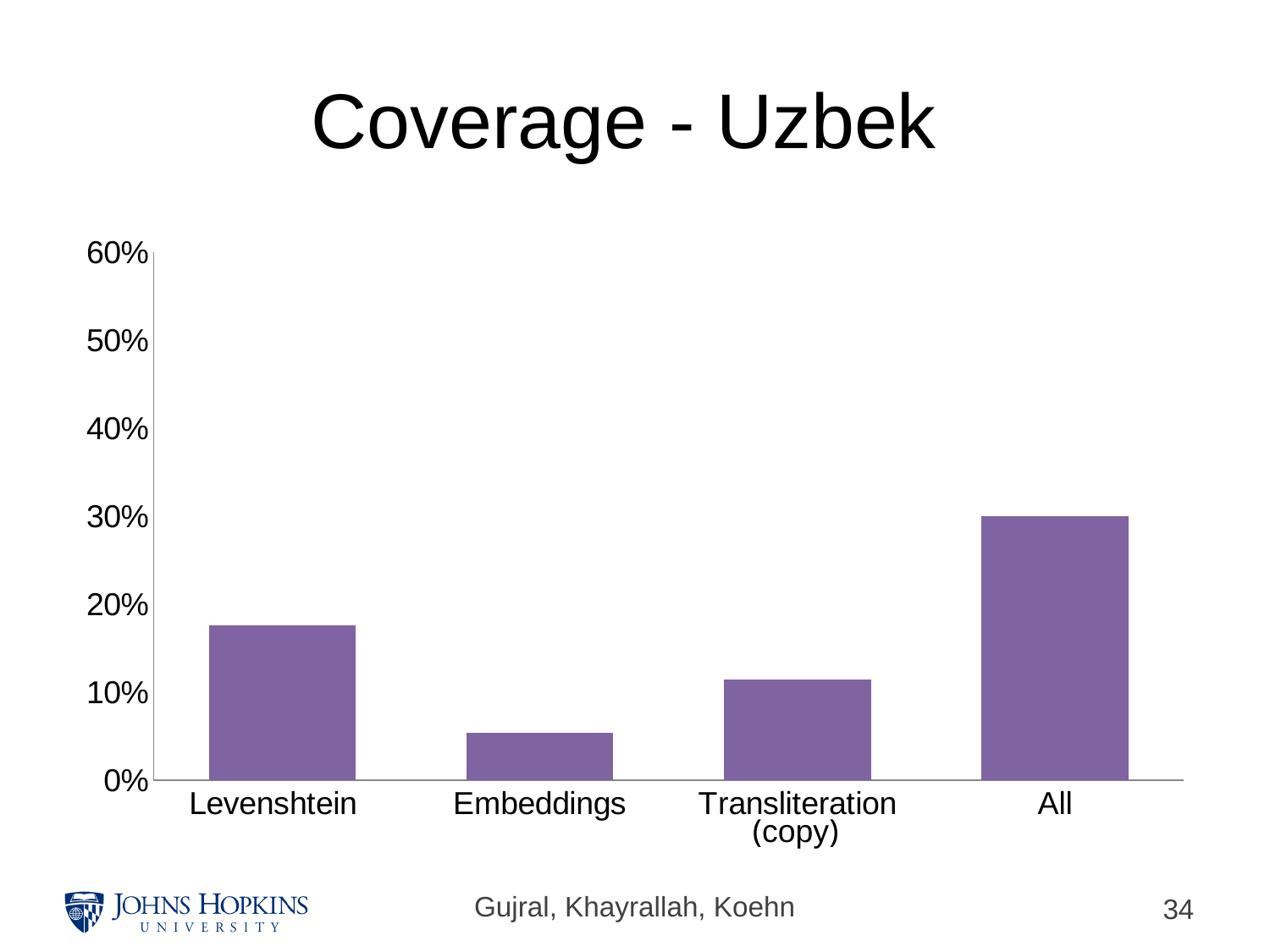
Is the value for Transliteration (copy) greater or less than 10%? greater Which category has the lowest coverage? Embeddings What kind of chart is shown on the slide? bar chart Is the value for Embeddings greater or less than 10%? less What is the highest value shown on the y axis of the chart? 60% Which category has the highest coverage? All Is the value for All greater or less than 20%? greater What is the title of the chart? Coverage - Uzbek Which has higher coverage, Levenshtein or Transliteration (copy)? Levenshtein How many categories are shown on the x axis of the chart? 4 Which has higher coverage, Embeddings or Transliteration (copy)? Transliteration (copy)